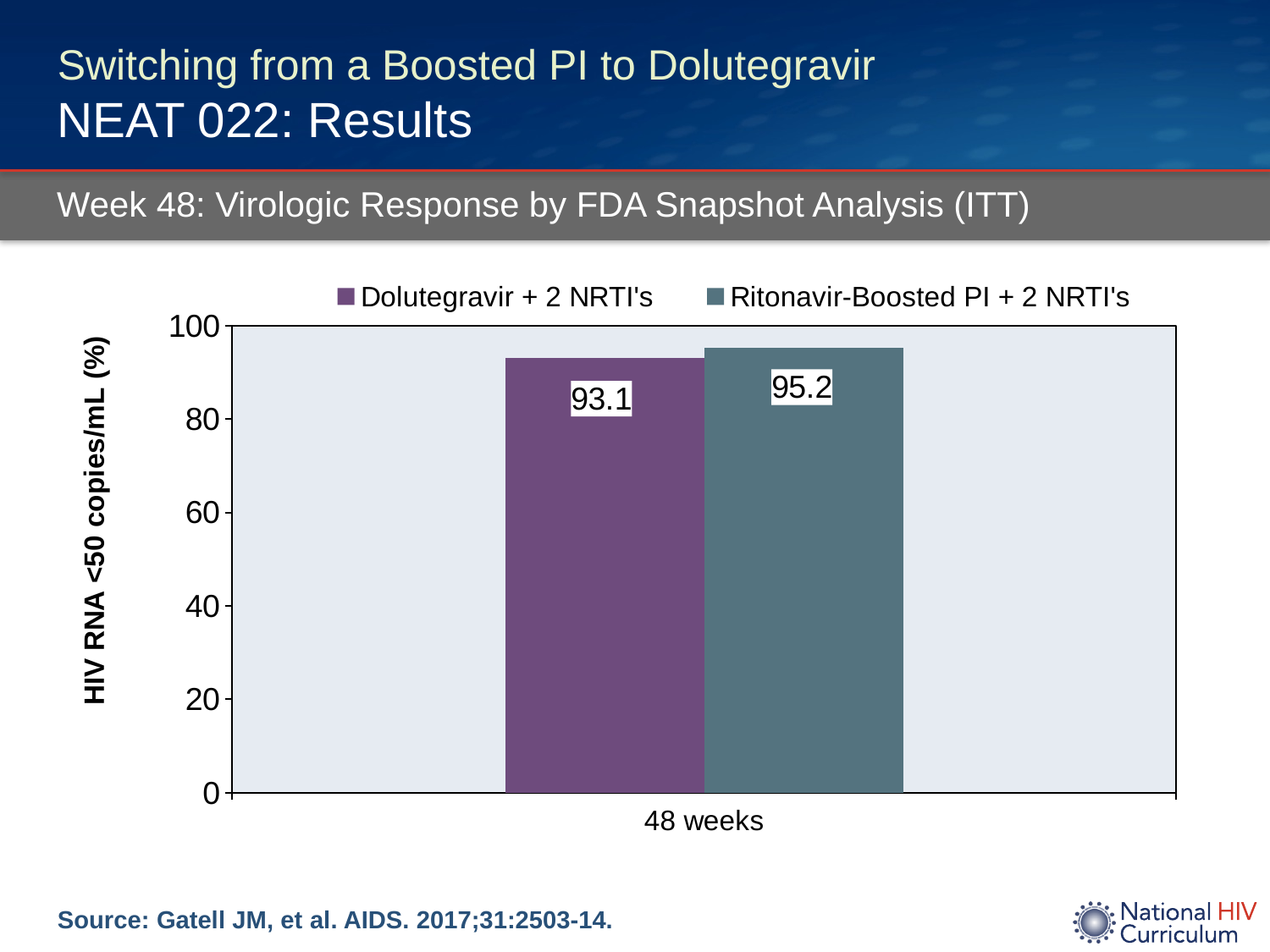
Which series has the higher value at 48 weeks? Ritonavir-Boosted PI + 2 NRTI's How many series does the legend list? 2 What is the label of the y axis? HIV RNA <50 copies/mL (%) What is the category label on the x axis? 48 weeks Is the value for Ritonavir-Boosted PI + 2 NRTI's greater or less than 100? less What kind of chart is shown on the slide? Bar chart What is the value for Dolutegravir + 2 NRTI's at 48 weeks? 93.1 What is the value for Ritonavir-Boosted PI + 2 NRTI's at 48 weeks? 95.2 Is the value for Dolutegravir + 2 NRTI's greater or less than 80? greater How many categories are shown on the x axis? 1 Which series has the lower value at 48 weeks? Dolutegravir + 2 NRTI's What is the difference between the Ritonavir-Boosted PI + 2 NRTI's value and the Dolutegravir + 2 NRTI's value at 48 weeks? 2.1